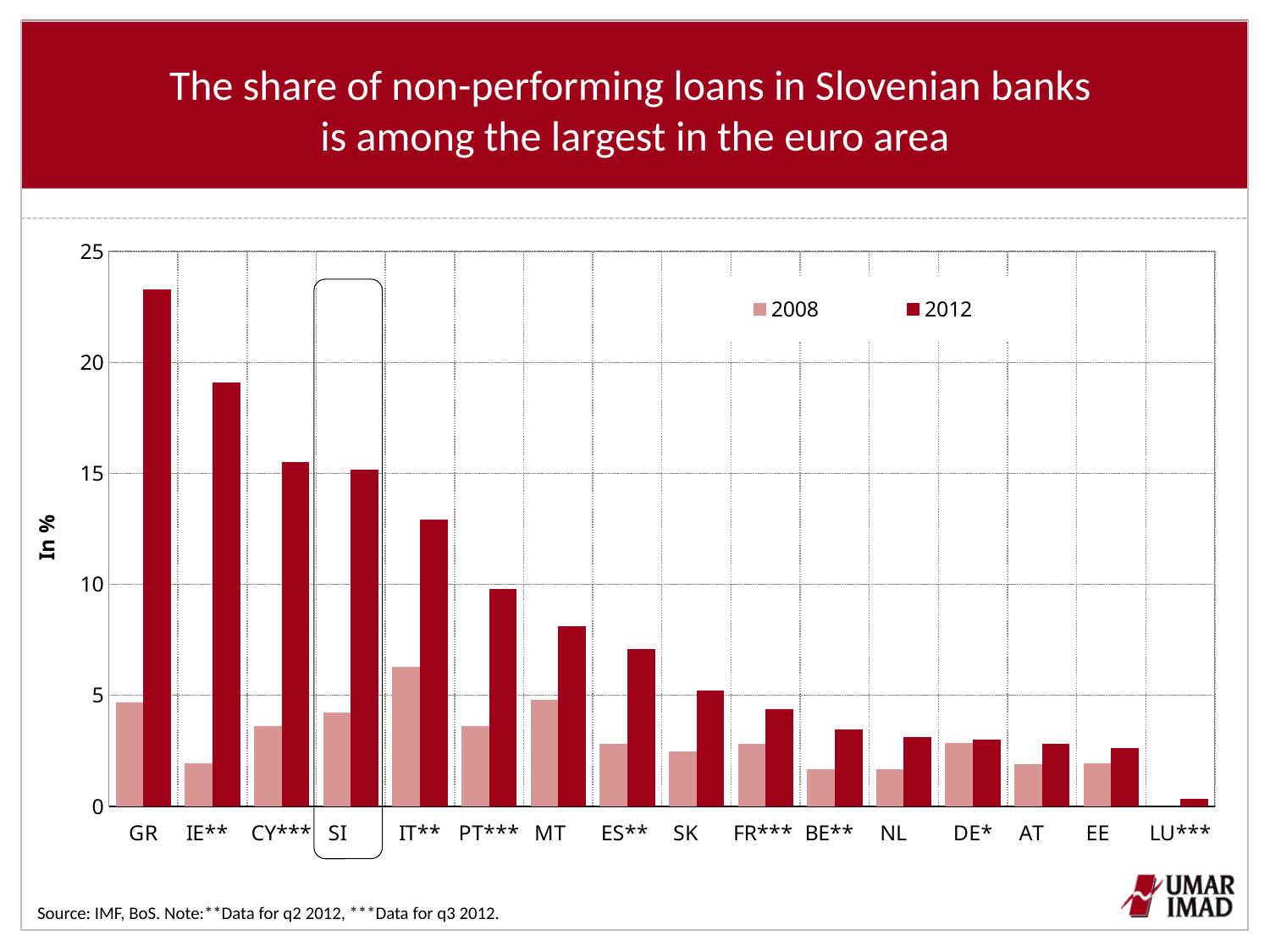
What kind of chart is shown on the slide? bar chart What is the label of the y axis? In % How many series does the legend list? 2 Which country has the highest 2012 value? GR Which country has the lowest 2012 value? LU*** How many countries are shown on the x axis? 16 Is the 2012 value for MT greater or less than 5? greater Is the 2012 value for SI greater or less than 10? greater Is the 2012 value for GR greater or less than 20? greater Which country has the highest 2008 value? IT** Which is larger, the 2012 value for SI or the 2012 value for IT**? SI Do the 2012 values generally rise or fall moving from left to right along the x axis? fall